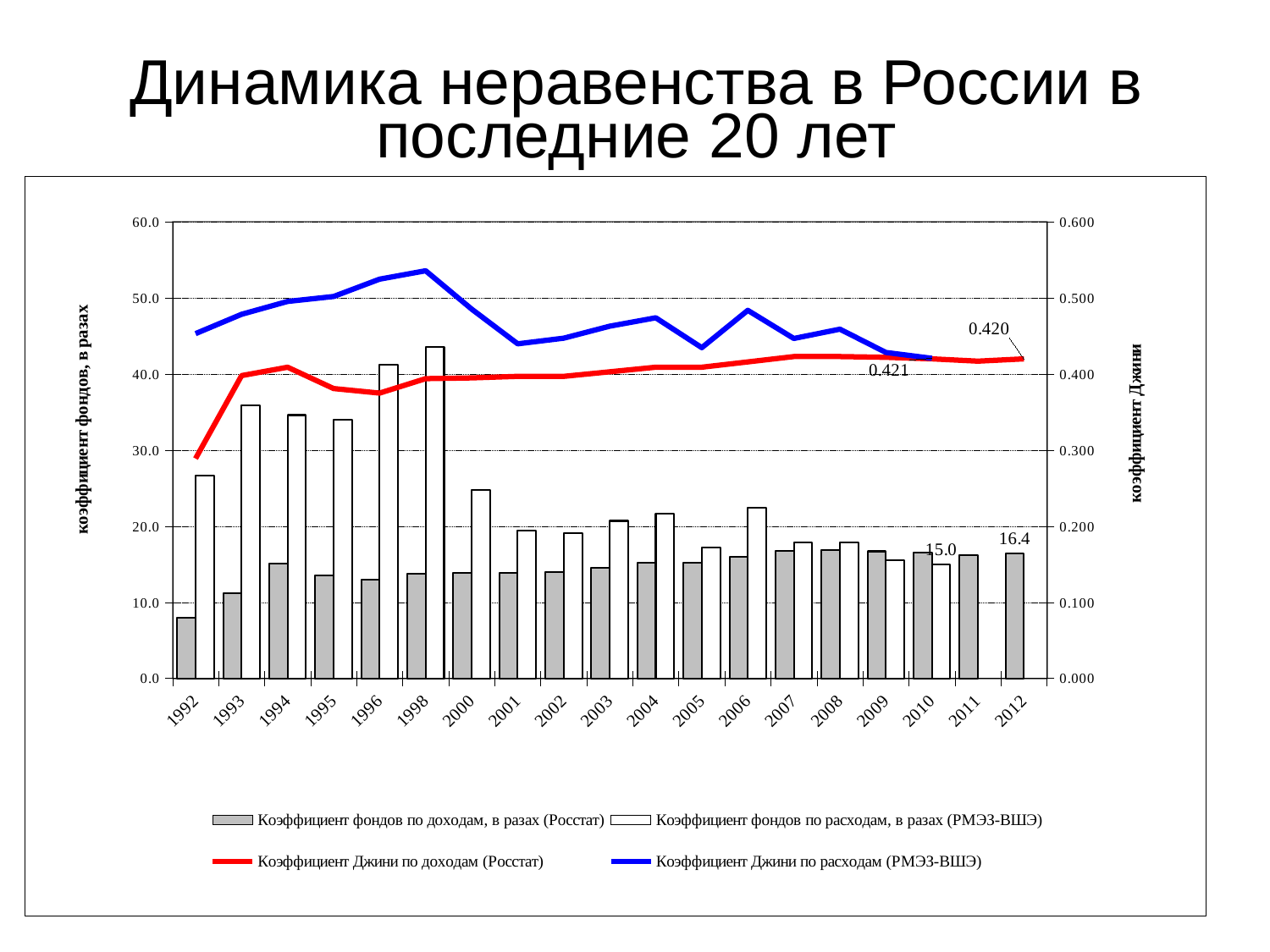
In 1996, which line is higher: the blue line (Джини по расходам) or the red line (Джини по доходам)? The blue line (Джини по расходам) How many series does the legend list? 4 What is the value of the white bar (Коэффициент фондов по расходам, РМЭЗ-ВШЭ) for 2010? 15.0 In which year is the white bar (Коэффициент фондов по расходам) the highest? 1998 What is the value of the red line (Коэффициент Джини по доходам, Росстат) for 2012? 0.420 Is the white bar (Коэффициент фондов по расходам) for 1993 greater or less than 30.0? greater What is the value of the grey bar (Коэффициент фондов по доходам, Росстат) for 2012? 16.4 Is the blue line (Коэффициент Джини по расходам) for 1998 greater or less than 0.500? greater How many years are shown on the x axis? 19 What kind of chart is shown on the slide? A combined bar and line chart In which year is the grey bar (Коэффициент фондов по доходам) the lowest? 1992 What is the title of the left vertical axis? коэффициент фондов, в разах